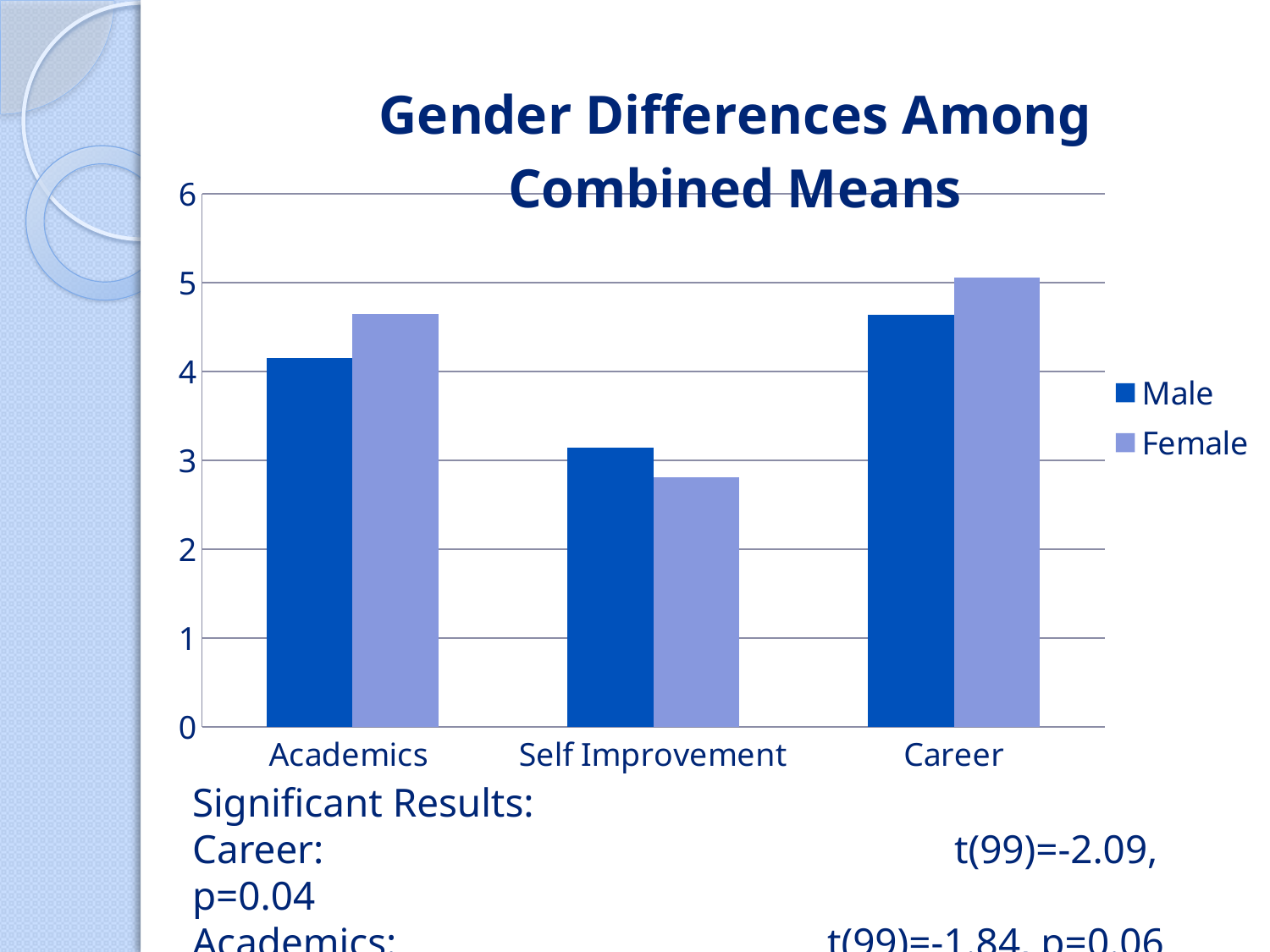
What is the title of the chart? Gender Differences Among Combined Means Which category has the lowest Female value? Self Improvement Which category has the highest Female value? Career Which category has the highest Male value? Career For Self Improvement, which is larger, the Male value or the Female value? Male What kind of chart is shown on the slide? bar chart Is the Male value for Academics greater or less than 4? greater Which category has the lowest Male value? Self Improvement For Academics, which is larger, the Male value or the Female value? Female How many categories are shown on the x axis? 3 How many series does the legend list? 2